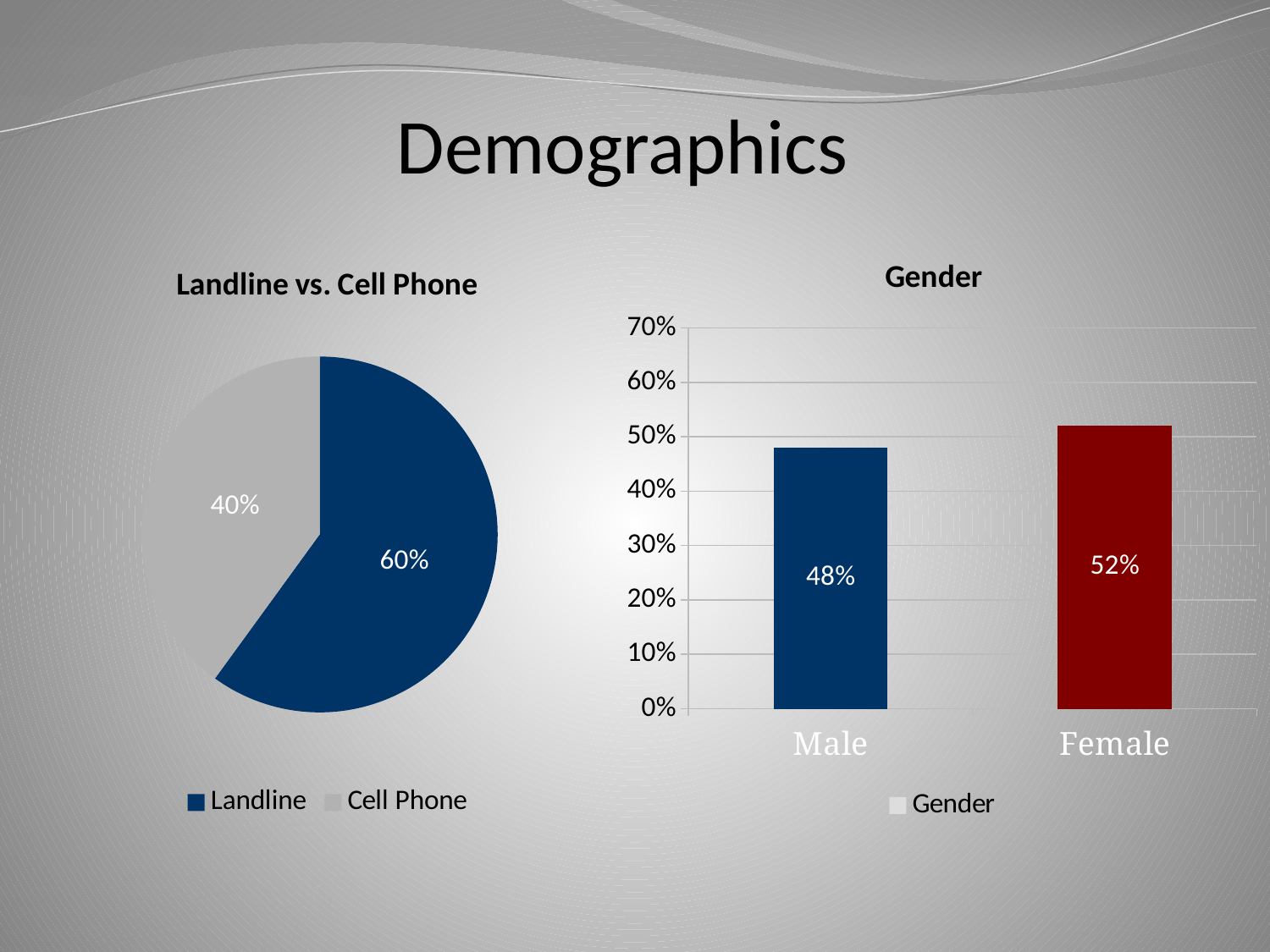
In the 'Landline vs. Cell Phone' chart, which slice is larger, Landline or Cell Phone? Landline What kind of chart is the 'Landline vs. Cell Phone' chart? Pie chart In the 'Gender' chart, what is the value for Female? 52% In the 'Gender' chart, is the value for Male greater or less than 50%? less In the 'Landline vs. Cell Phone' chart, what share of the pie is Cell Phone? 40% How many slices does the 'Landline vs. Cell Phone' pie chart have? 2 In the 'Gender' chart, what is the value for Male? 48% In the 'Gender' chart, what is the highest value shown on the vertical axis? 70% In the 'Gender' chart, which category has the highest value? Female In the 'Gender' chart, what is the difference between the Female and Male values? 4% What kind of chart is the 'Gender' chart? Bar chart In the 'Landline vs. Cell Phone' chart, what share of the pie is Landline? 60%